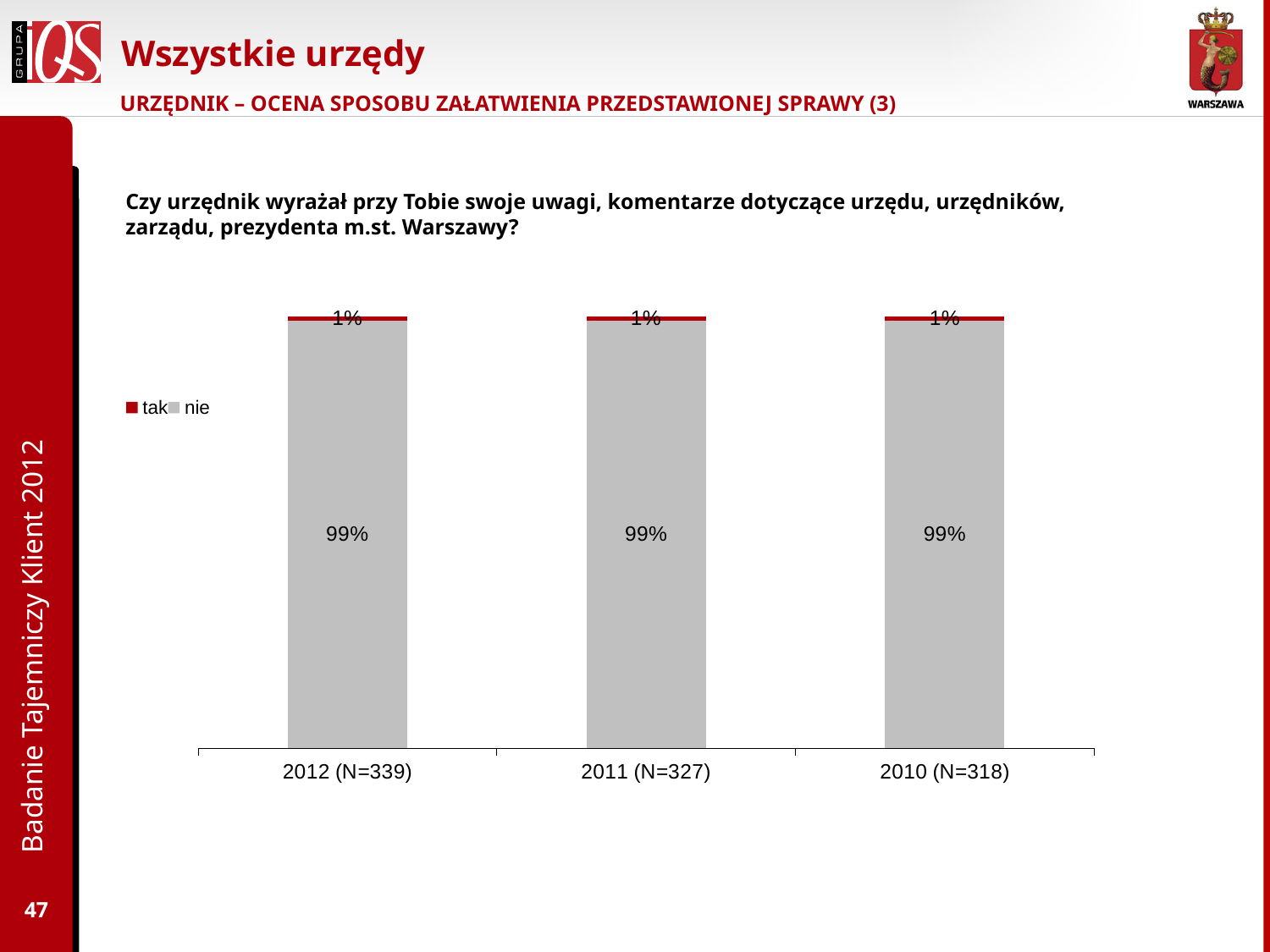
What is the value for "nie" in 2012 (N=339)? 99% What is the value for "tak" in 2012 (N=339)? 1% Which is larger in 2011 (N=327): "tak" or "nie"? nie How many series does the legend list? 2 How many categories are shown on the x axis? 3 What is the value for "nie" in 2010 (N=318)? 99% What kind of chart is shown on the slide? stacked bar chart What is the total of the stacked bar for 2012 (N=339)? 100% What is the value for "tak" in 2011 (N=327)? 1% Does the value for "nie" rise, fall or stay the same across the three categories? stays the same What colour represents the "tak" series in the legend? red What is the difference between "nie" and "tak" in 2010 (N=318)? 98%